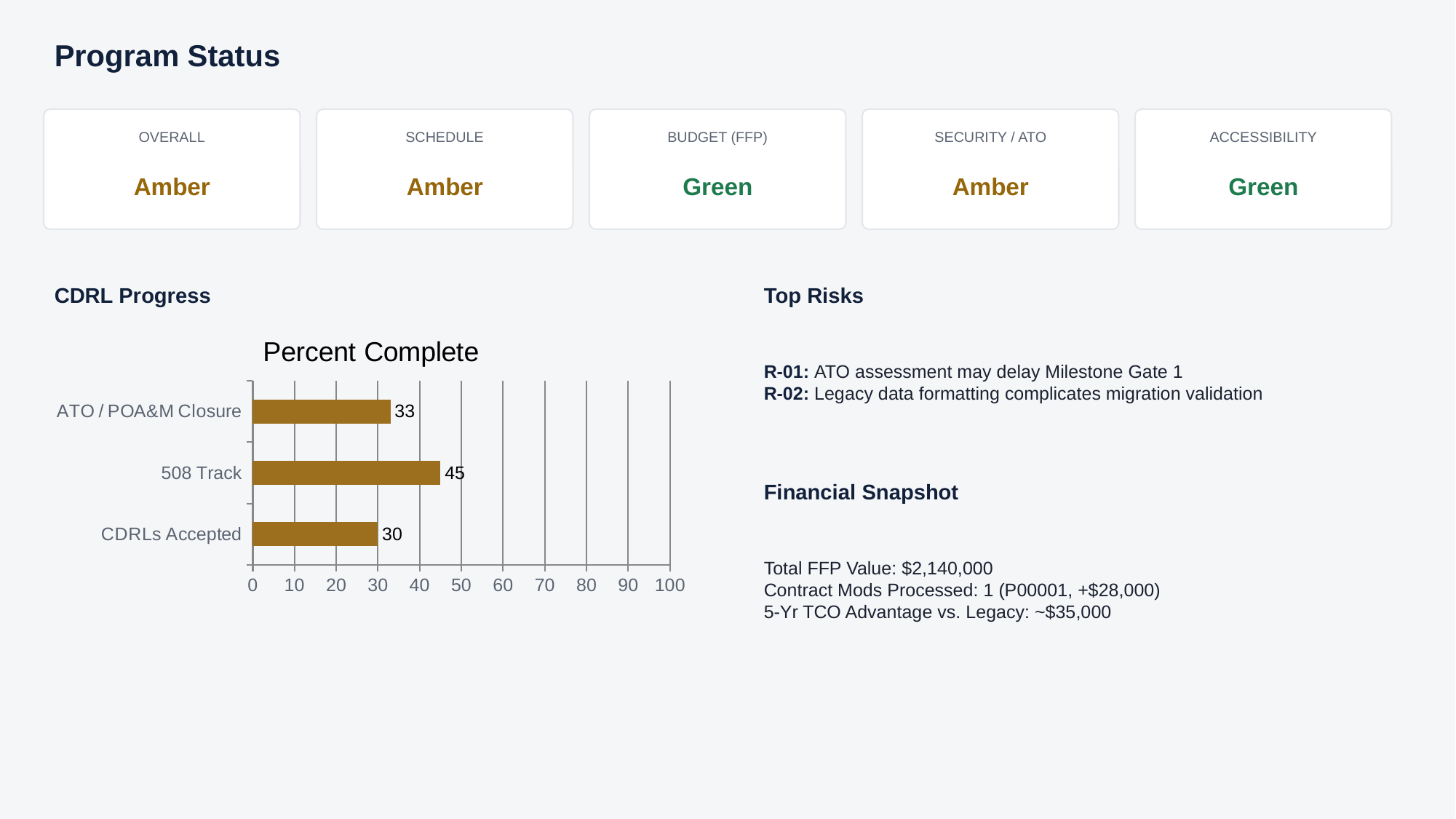
What kind of chart is the Percent Complete chart? bar chart What is the title of the chart on the slide? Percent Complete What is the difference between the values for ATO / POA&M Closure and CDRLs Accepted in the Percent Complete chart? 3 What is the value for 508 Track in the Percent Complete chart? 45 Which category has the highest value in the Percent Complete chart? 508 Track Is the value for 508 Track in the Percent Complete chart greater or less than 50? less Which is larger in the Percent Complete chart: 508 Track or ATO / POA&M Closure? 508 Track What is the difference between the values for 508 Track and CDRLs Accepted in the Percent Complete chart? 15 How many categories are shown in the Percent Complete chart? 3 Which category has the lowest value in the Percent Complete chart? CDRLs Accepted What is the value for ATO / POA&M Closure in the Percent Complete chart? 33 What is the value for CDRLs Accepted in the Percent Complete chart? 30